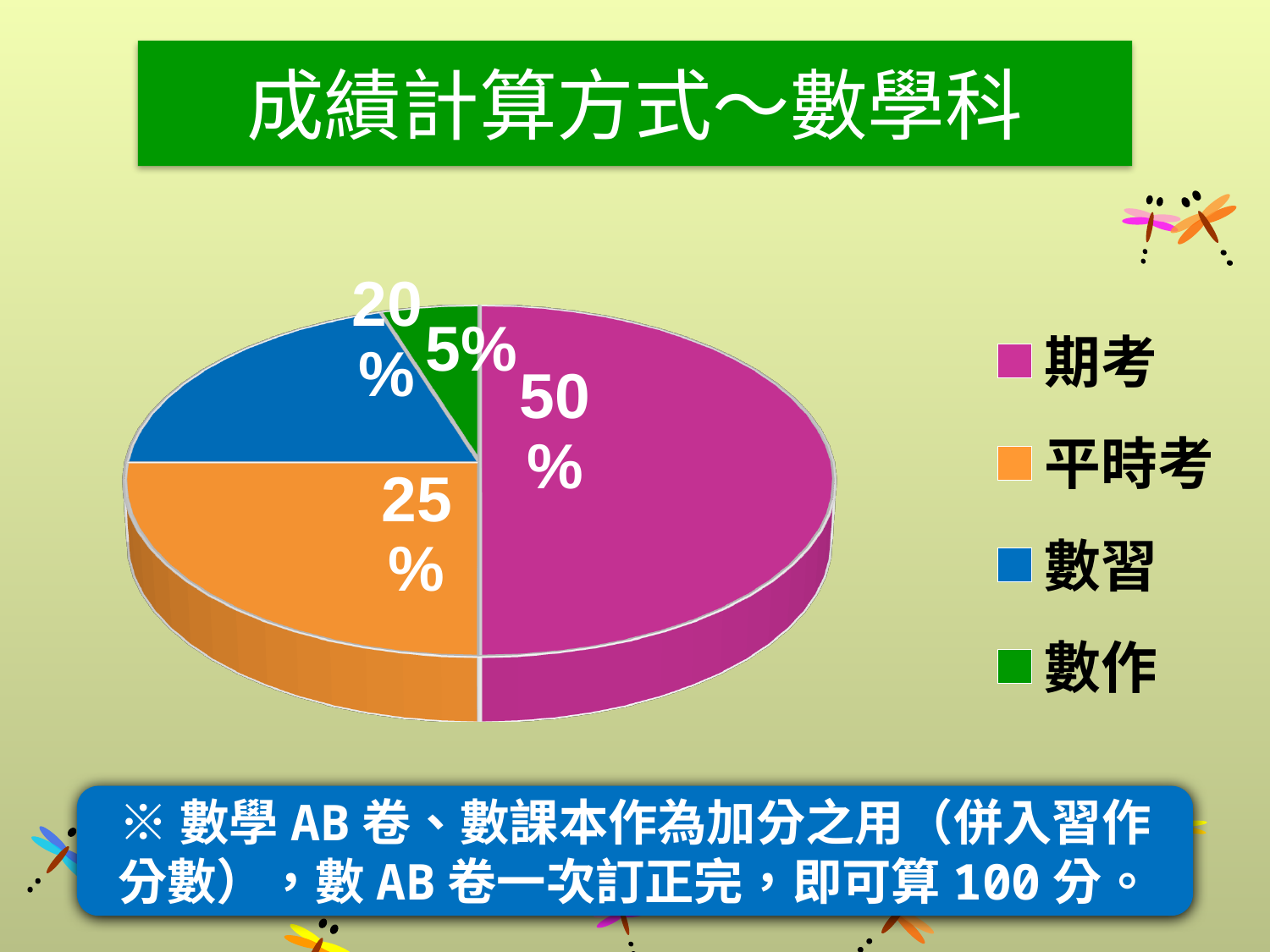
What is the difference between the shares of 期考 and 平時考? 25% How many categories does the pie chart have? 4 Which category has the smallest slice of the pie? 數作 What is the difference between the shares of 數習 and 數作? 15% What share of the pie does 平時考 take? 25% What kind of chart is shown on the slide? pie chart What share of the pie does 數習 take? 20% What share of the pie does 數作 take? 5% Which is larger, the share of 平時考 or the share of 數習? 平時考 Which category has the largest slice of the pie? 期考 What colour is the slice for 數習? blue